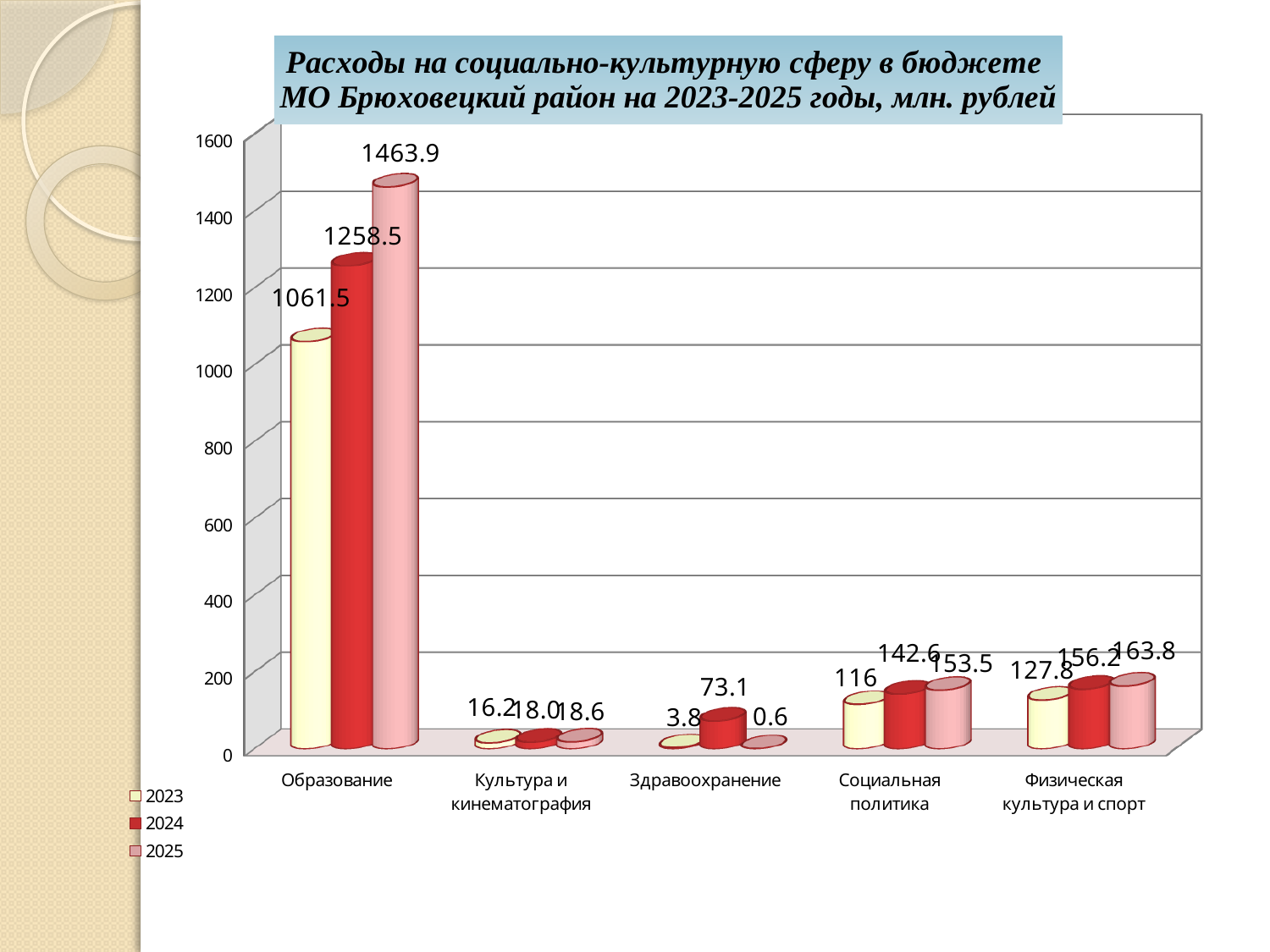
What is the value for Здравоохранение in 2024? 73.1 Which category has the highest value in 2024? Образование How many categories are shown on the x axis? 5 Is the 2023 value for Образование greater or less than 1000? greater Which category has the lowest value in 2025? Здравоохранение What is the difference between the 2025 and 2023 values for Образование? 402.4 What kind of chart is shown on the slide? bar chart How many series does the legend list? 3 Which is larger: the 2024 value for Социальная политика or the 2024 value for Физическая культура и спорт? Физическая культура и спорт What is the value for Физическая культура и спорт in 2025? 163.8 What is the value for Образование in 2025? 1463.9 What is the value for Социальная политика in 2023? 116